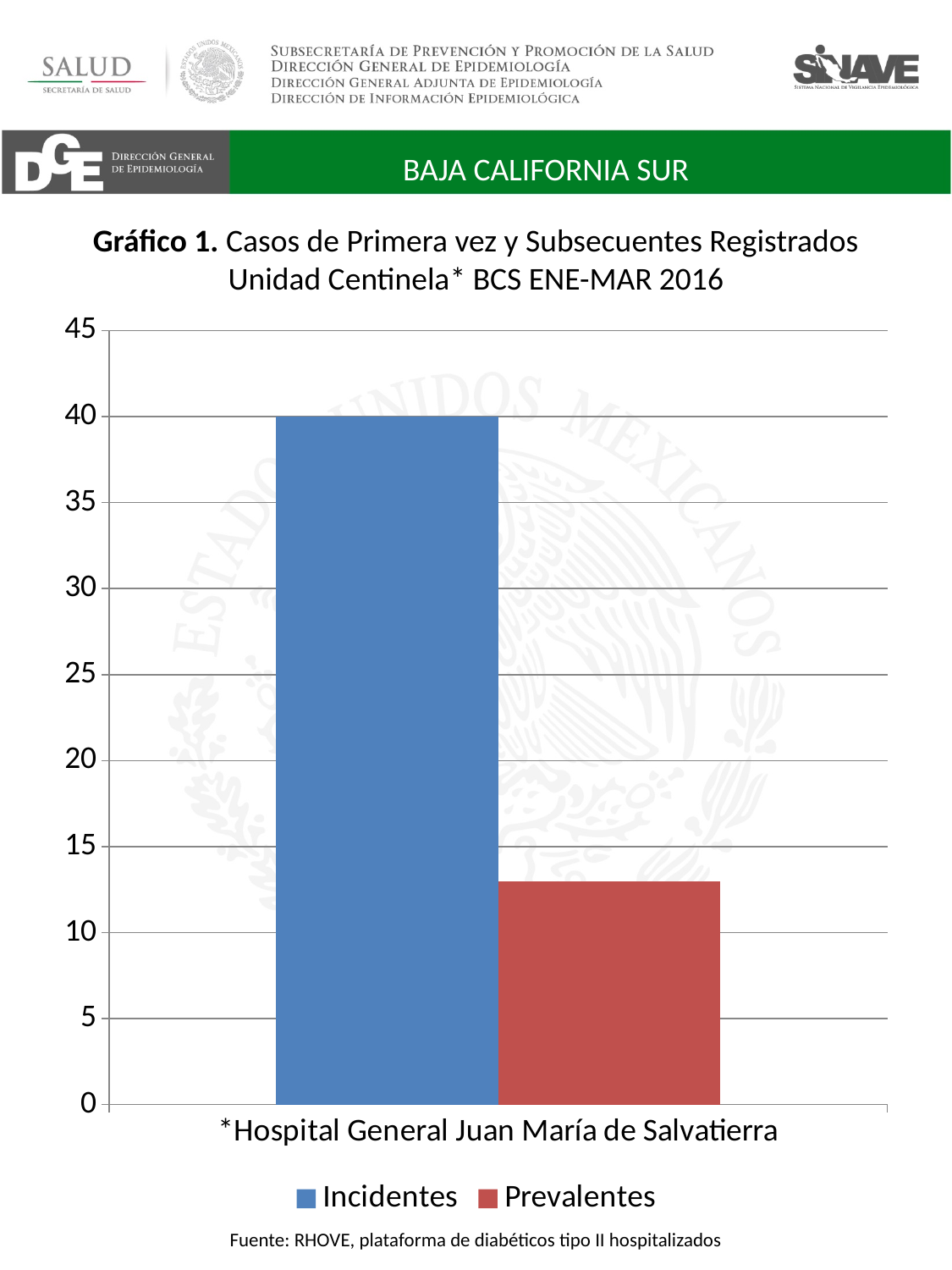
Which series has the higher value, Incidentes or Prevalentes? Incidentes Which series has the lowest value? Prevalentes Is the value for Prevalentes greater or less than 15? less What are the two series named in the legend? Incidentes and Prevalentes What colour is the Prevalentes bar? red What is the maximum value shown on the y axis? 45 How many categories are shown on the x axis? 1 What type of chart is shown on the slide? bar chart What is the value of the Incidentes bar? 40 How many series does the legend list? 2 Is the value for Prevalentes greater or less than 10? greater Is the value for Incidentes greater or less than 35? greater